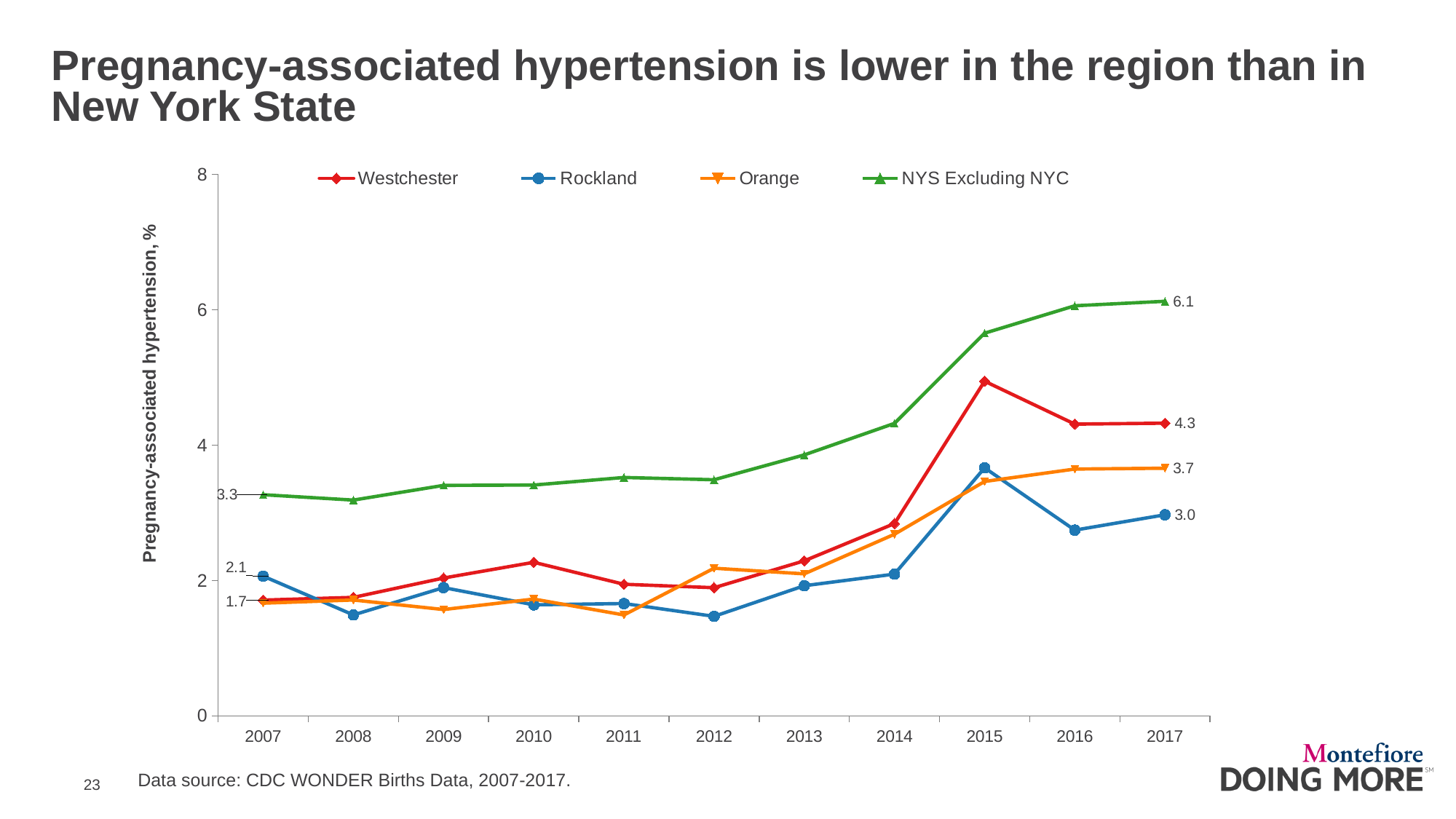
Is the value for NYS Excluding NYC in 2015 greater or less than 4? greater Does the NYS Excluding NYC line generally rise or fall from 2007 to 2017? rise How many years are plotted along the x axis? 11 Which is larger in 2017, Westchester or Orange? Westchester What is the value for NYS Excluding NYC in 2007? 3.3 How many series does the legend list? 4 What is the value for NYS Excluding NYC in 2017? 6.1 Which series has the lowest value in 2017? Rockland By how much did the NYS Excluding NYC value increase from 2007 to 2017? 2.8 What is the value for Rockland in 2007? 2.1 What kind of chart is shown on the slide? line chart What is the value for Westchester in 2017? 4.3